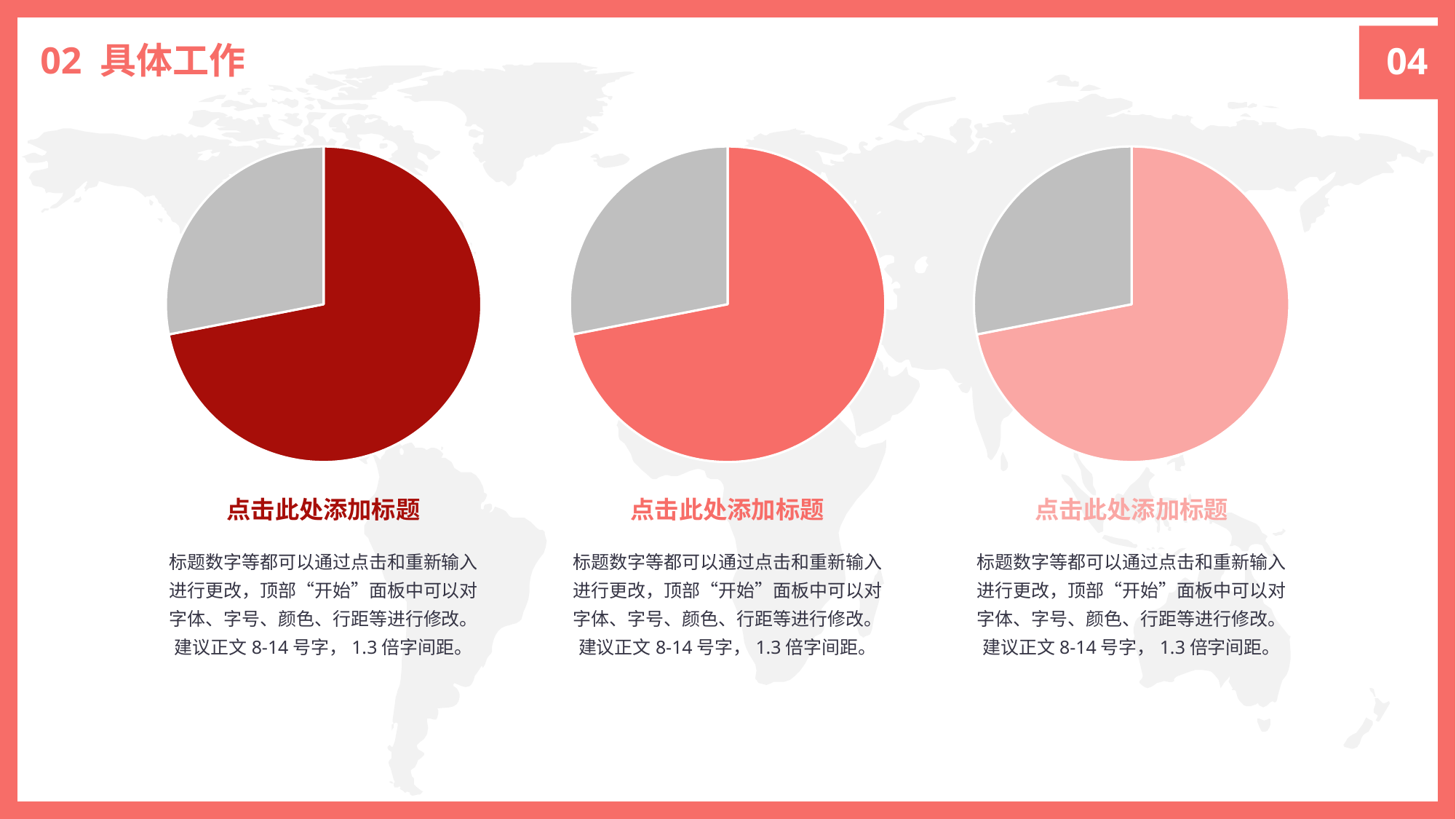
In the left pie chart, which slice is larger, the dark red slice or the gray slice? the dark red slice What colour is the smaller slice in each of the three pie charts? gray How many pie charts are shown on the slide? 3 How many slices does the right pie chart have? 2 How many slices does the middle pie chart have? 2 Does the gray slice of the left pie chart take up more or less than half of the pie? less Does the colored slice of the right pie chart take up more or less than half of the pie? more In the right pie chart, which slice is larger, the pink slice or the gray slice? the pink slice What kind of chart is the left chart on the slide? pie chart In the middle pie chart, which slice is larger, the red slice or the gray slice? the red slice What kind of chart is the right chart on the slide? pie chart